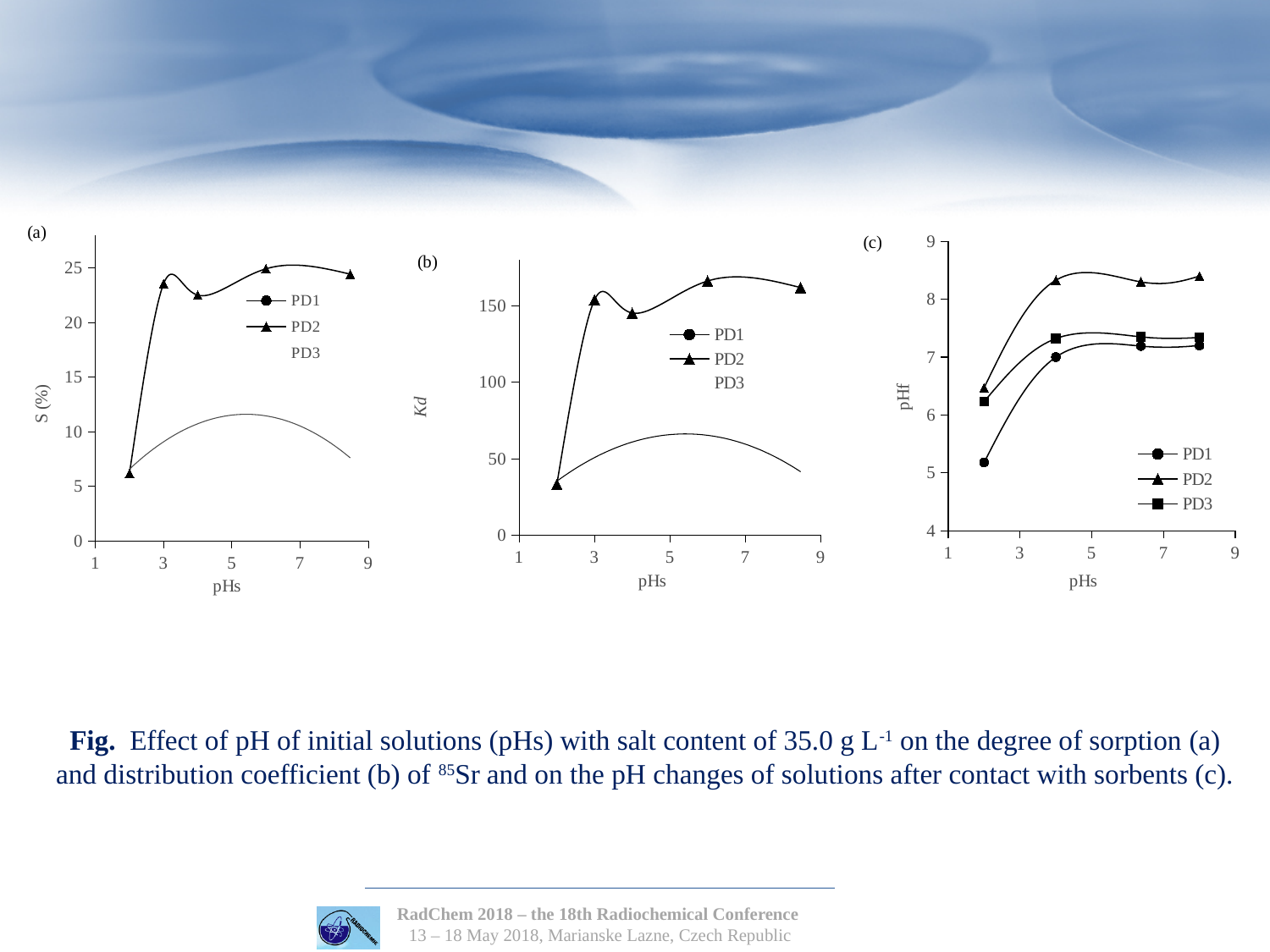
In chart (c), does the PD1 series rise or fall from pHs 2 to pHs 4? rise In chart (b), is the value of PD2 at pHs 6 greater or less than 150? greater In chart (b), is the value of PD2 at pHs 2 greater or less than 50? less How many series does the legend of chart (c) list? 3 In chart (a), is the value of PD2 at pHs 2 greater or less than 10? less In chart (c), which series has the highest pHf at pHs 8? PD2 In chart (c), at pHs 2, which is larger: PD1 or PD2? PD2 What is the y-axis title of chart (b)? Kd What kind of chart is chart (a)? line chart